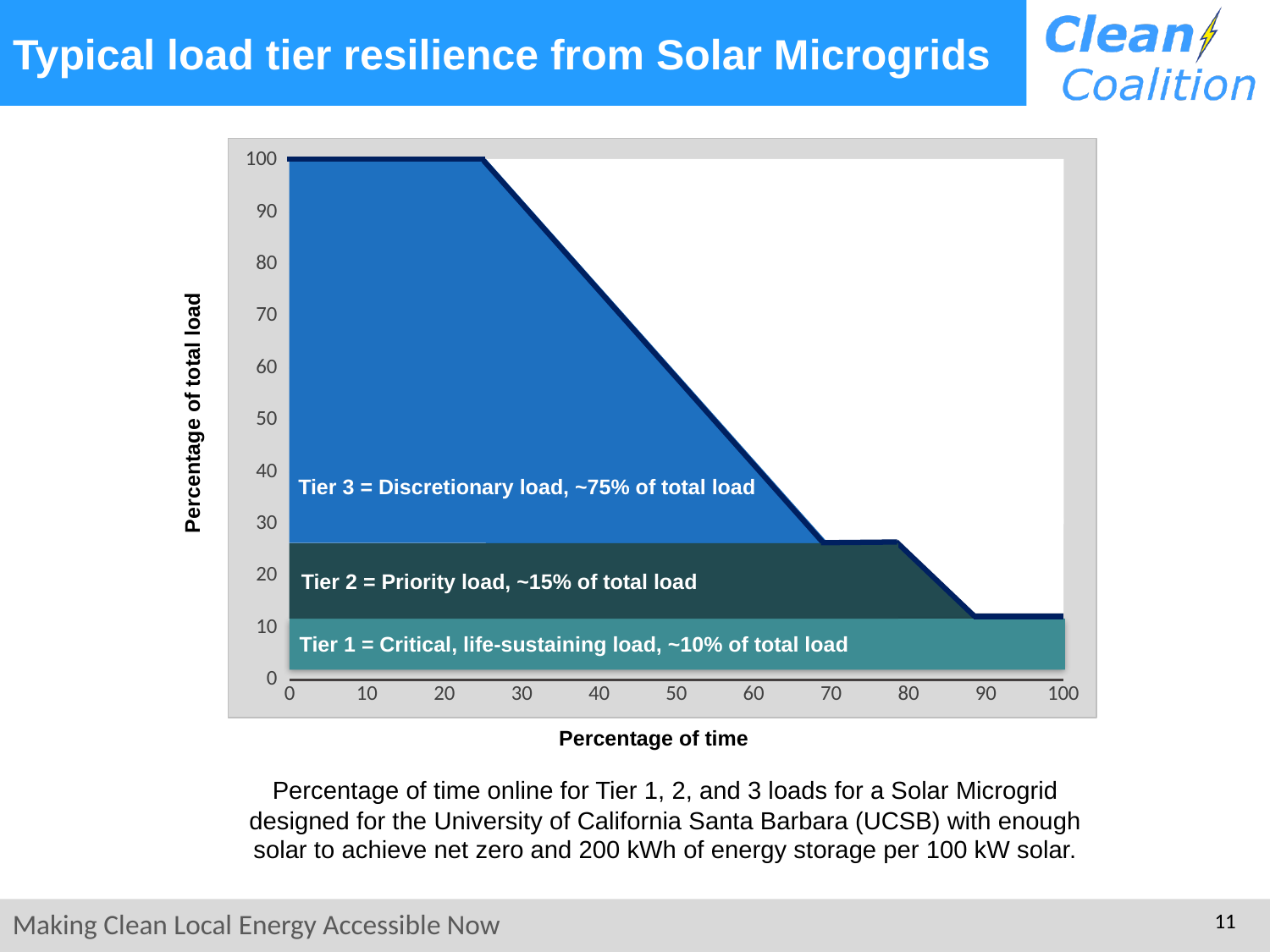
What kind of chart is shown on the slide? Area chart Which is larger: the percentage of total load at 20% of time or at 60% of time? 20% of time Does the percentage of total load rise or fall as the percentage of time increases? Fall What is the label of the x axis? Percentage of time Is the percentage of total load at 40% of time greater or less than 70? greater What is the percentage of total load at 0% of time? 100 Is the percentage of total load at 10% of time greater or less than 90? greater Is the percentage of total load at 75% of time greater or less than 30? less How many load tiers are labelled on the chart? 3 What is the label of the y axis? Percentage of total load